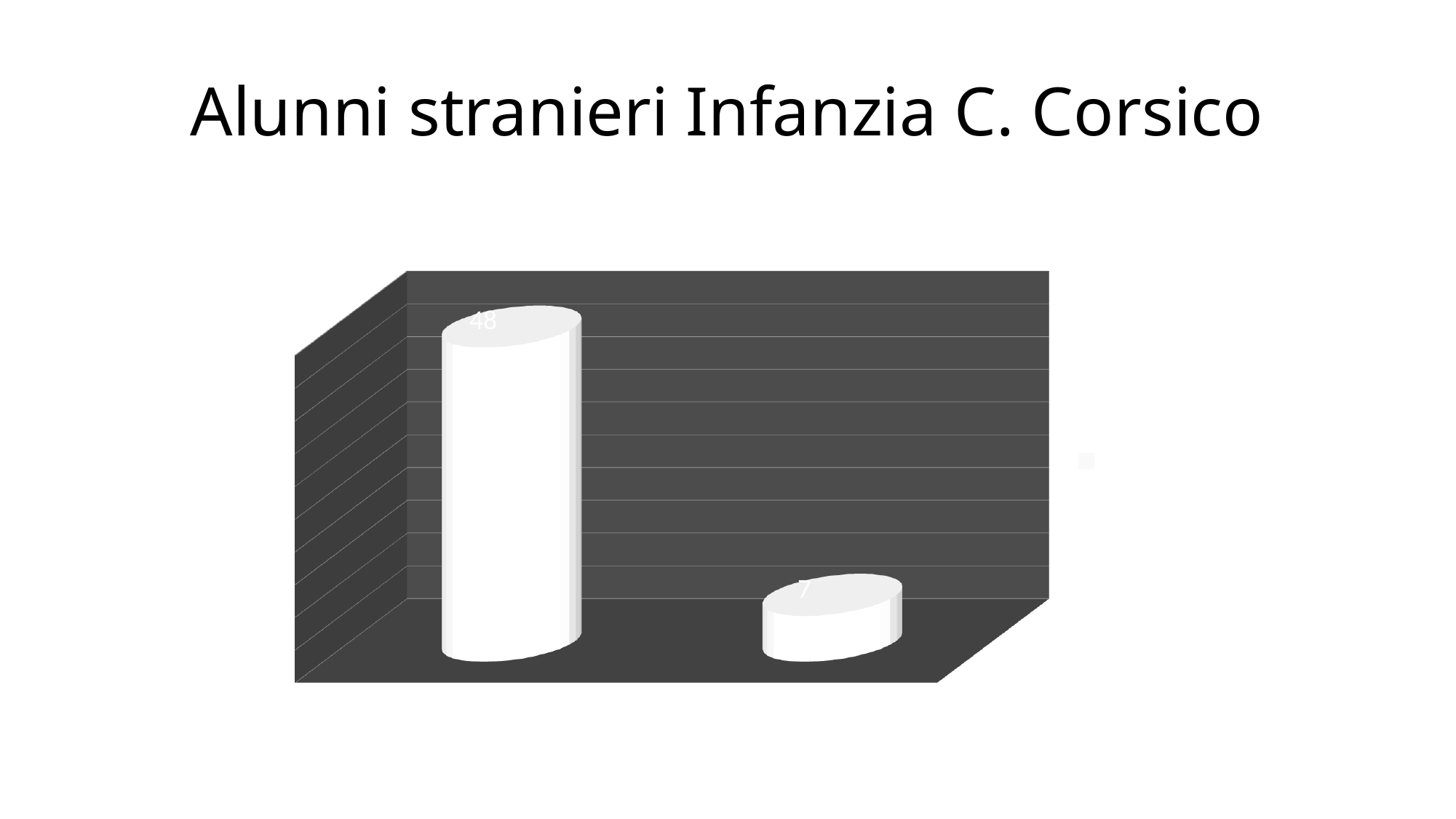
Do the values rise or fall from left to right across the chart? fall Which bar has the lowest value, the left or the right one? the right bar What is the difference between the values of the left bar and the right bar? 41 What value is shown on the left bar of the chart? 48 Is the value of the left bar larger or smaller than the value of the right bar? larger What value is shown on the right bar of the chart? 7 How many bars are plotted in the chart? 2 What is the title of the slide? Alunni stranieri Infanzia C. Corsico Which bar has the highest value, the left or the right one? the left bar What kind of chart is shown on the slide? bar chart